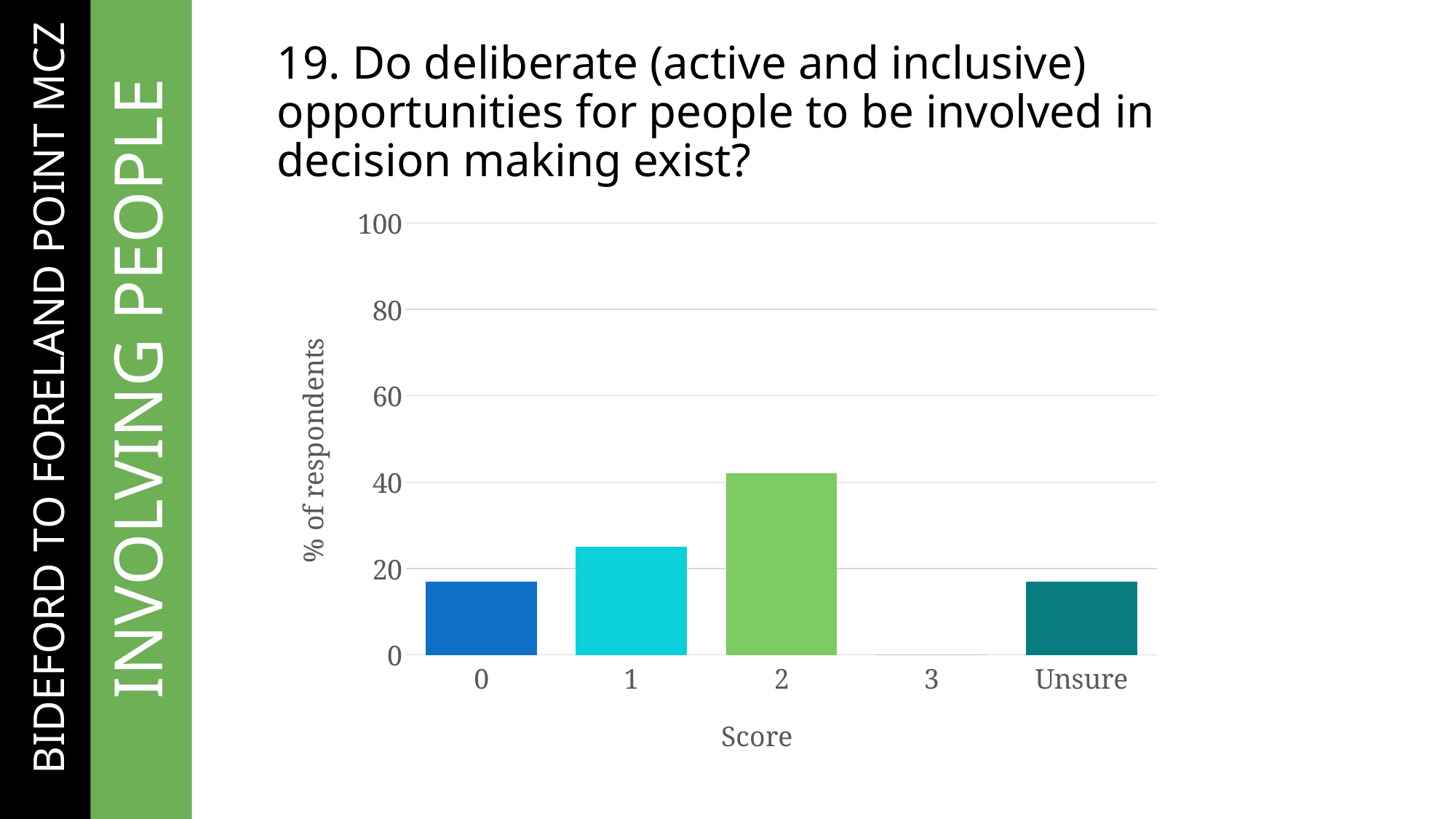
Which score category has the highest percentage of respondents? 2 Is the value for score 0 greater or less than 20? less Which score category has the lowest percentage of respondents? 3 Which has a higher percentage of respondents, score 2 or score 1? 2 What kind of chart is shown on the slide? bar chart How many score categories are shown on the x axis of the chart? 5 Which has a higher percentage of respondents, score 1 or score 0? 1 Is the value for score 1 greater or less than 20? greater Is the value for score 2 greater or less than 40? greater What is the label of the y axis of the chart? % of respondents What is the label of the x axis of the chart? Score